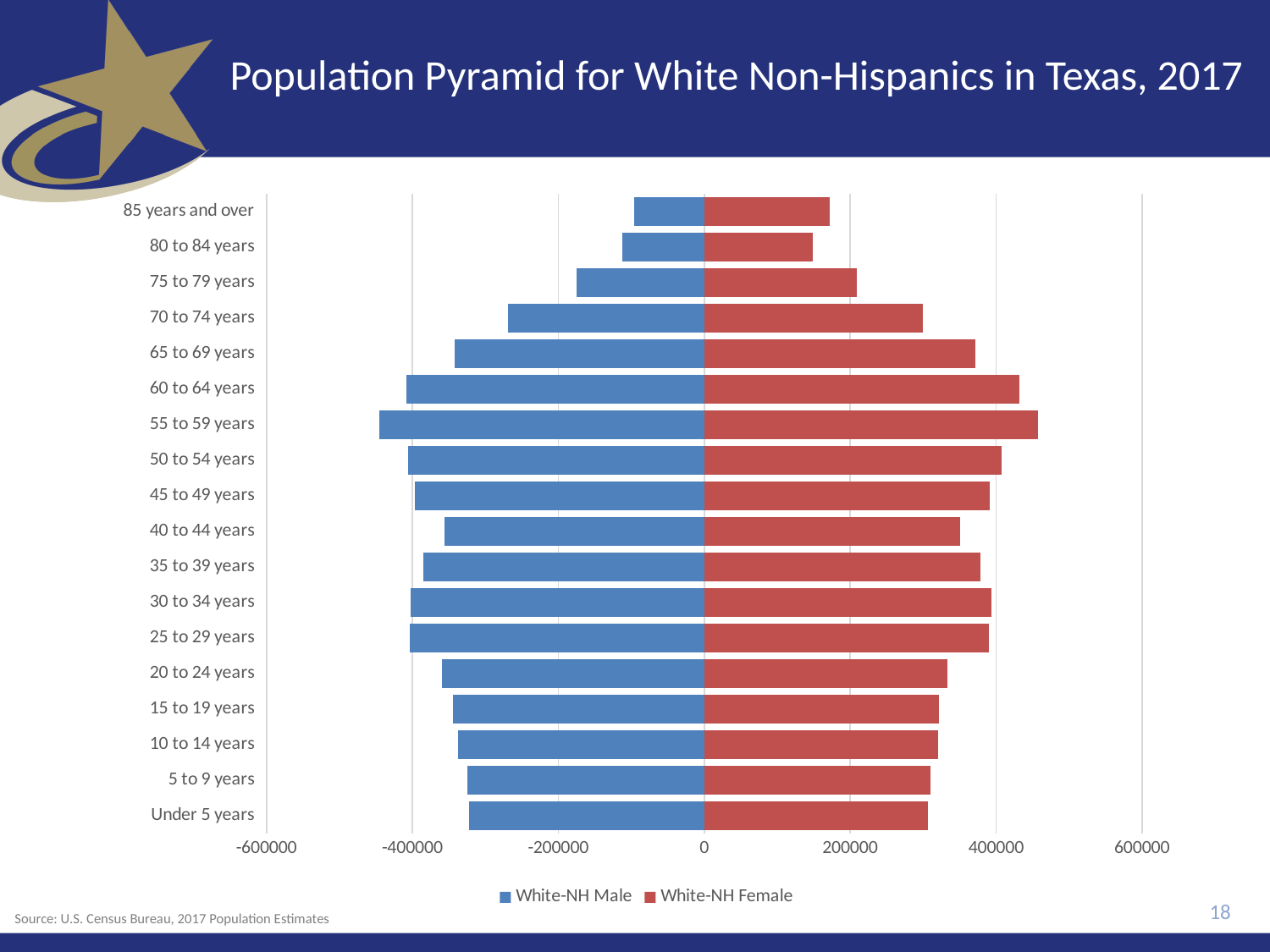
What kind of chart is shown on the slide? Bar chart Which age group has the shortest White-NH Male bar? 85 years and over How many series does the chart legend list? 2 Which age group has the longest White-NH Female bar? 55 to 59 years Which age group has the longest White-NH Male bar? 55 to 59 years Which is larger, the White-NH Female value for 65 to 69 years or for 70 to 74 years? 65 to 69 years Is the White-NH Female value for 80 to 84 years greater or less than 200000? less How many age groups are listed on the vertical axis of the chart? 18 Is the White-NH Female value for 40 to 44 years greater or less than 400000? less Is the White-NH Female value for 55 to 59 years greater or less than 400000? greater What is the title of the chart on the slide? Population Pyramid for White Non-Hispanics in Texas, 2017 Which age group has the shortest White-NH Female bar? 80 to 84 years